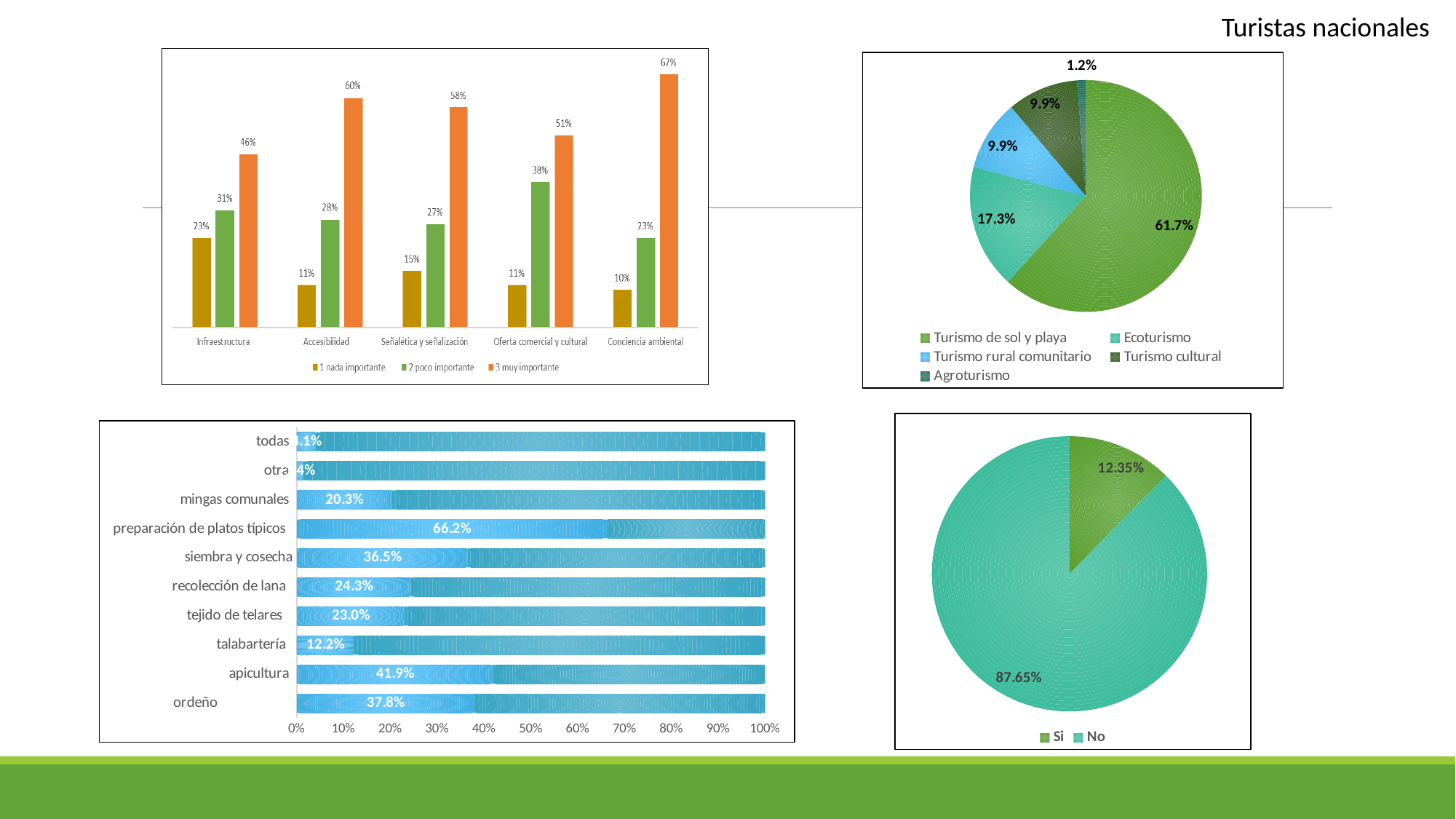
What kind of chart is the bottom-right chart? Pie chart In the top-left bar chart, what is the difference between the '3 muy importante' and '1 nada importante' values for Accesibilidad? 49% In the top-right pie chart, what share does Turismo de sol y playa have? 61.7% In the top-right pie chart, which category has the smallest slice? Agroturismo In the top-left bar chart, what is the value for '3 muy importante' in the Conciencia ambiental category? 67% How many series does the legend of the top-left bar chart list? 3 In the bottom-left bar chart, which is larger, the labelled value for 'apicultura' or for 'ordeño'? apicultura In the bottom-right pie chart, what share does 'No' have? 87.65% In the top-left bar chart, which category has the highest '2 poco importante' value? Oferta comercial y cultural How many categories does the legend of the top-right pie chart list? 5 In the bottom-left bar chart, what is the labelled value for 'preparación de platos típicos'? 66.2% In the top-left bar chart, what is the value for '1 nada importante' in the Infraestructura category? 23%